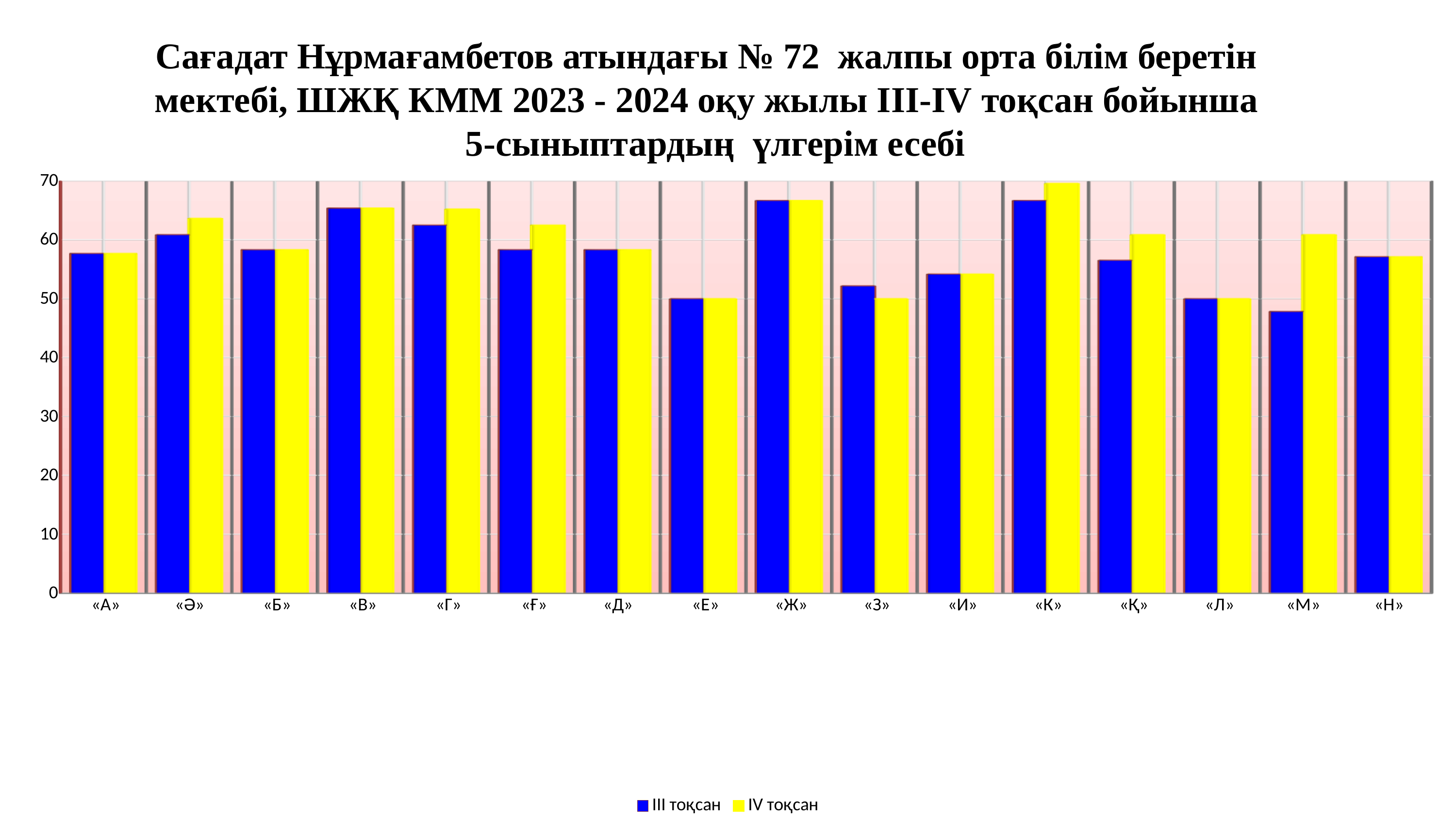
How many series does the legend list? 2 Is the III тоқсан value for «Ж» greater or less than 60? greater What kind of chart is shown on the slide? bar chart Is the III тоқсан value for «М» greater or less than 50? less Is the IV тоқсан value for «В» greater or less than 60? greater What is the III тоқсан value for «Е»? 50 For «М», which is larger: the III тоқсан value or the IV тоқсан value? IV тоқсан How many class categories are shown along the x axis? 16 Which category has the highest IV тоқсан value? «К» Which category has the lowest III тоқсан value? «М» What is the IV тоқсан value for «Л»? 50 Which series is shown in yellow? IV тоқсан